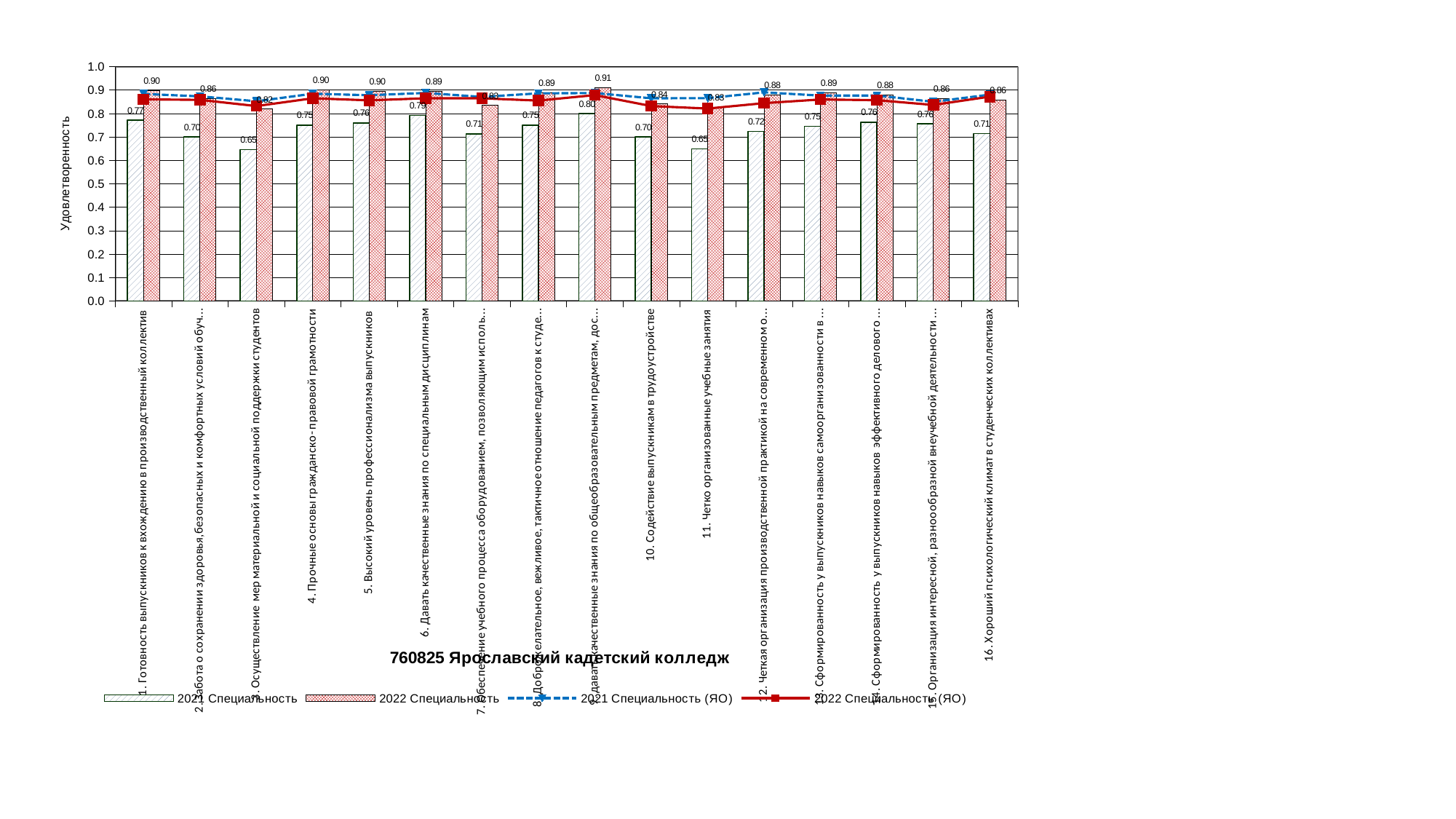
What is the 2021 Специальность value for "10. Содействие выпускникам в трудоустройстве"? 0.70 For "1. Готовность выпускников к вхождению в производственный коллектив", what is the difference between the 2022 Специальность and 2021 Специальность values? 0.13 Is the 2021 Специальность value for "3. Осуществление мер материальной и социальной поддержки студентов" greater or less than 0.7? less How many categories are shown on the x axis of the chart? 16 What is the title of the chart? 760825 Ярославский кадетский колледж What is the 2022 Специальность value for "4. Прочные основы гражданско-правовой грамотности"? 0.90 For "5. Высокий уровень профессионализма выпускников", what is the difference between the 2022 Специальность and 2021 Специальность values? 0.14 How many series does the legend list? 4 What is the 2022 Специальность value for "16. Хороший психологический климат в студенческих коллективах"? 0.86 What is the 2021 Специальность value for "11. Четко организованные учебные занятия"? 0.65 For "4. Прочные основы гражданско-правовой грамотности", which is larger: the 2021 Специальность or the 2022 Специальность value? 2022 Специальность What is the 2021 Специальность value for "1. Готовность выпускников к вхождению в производственный коллектив"? 0.77